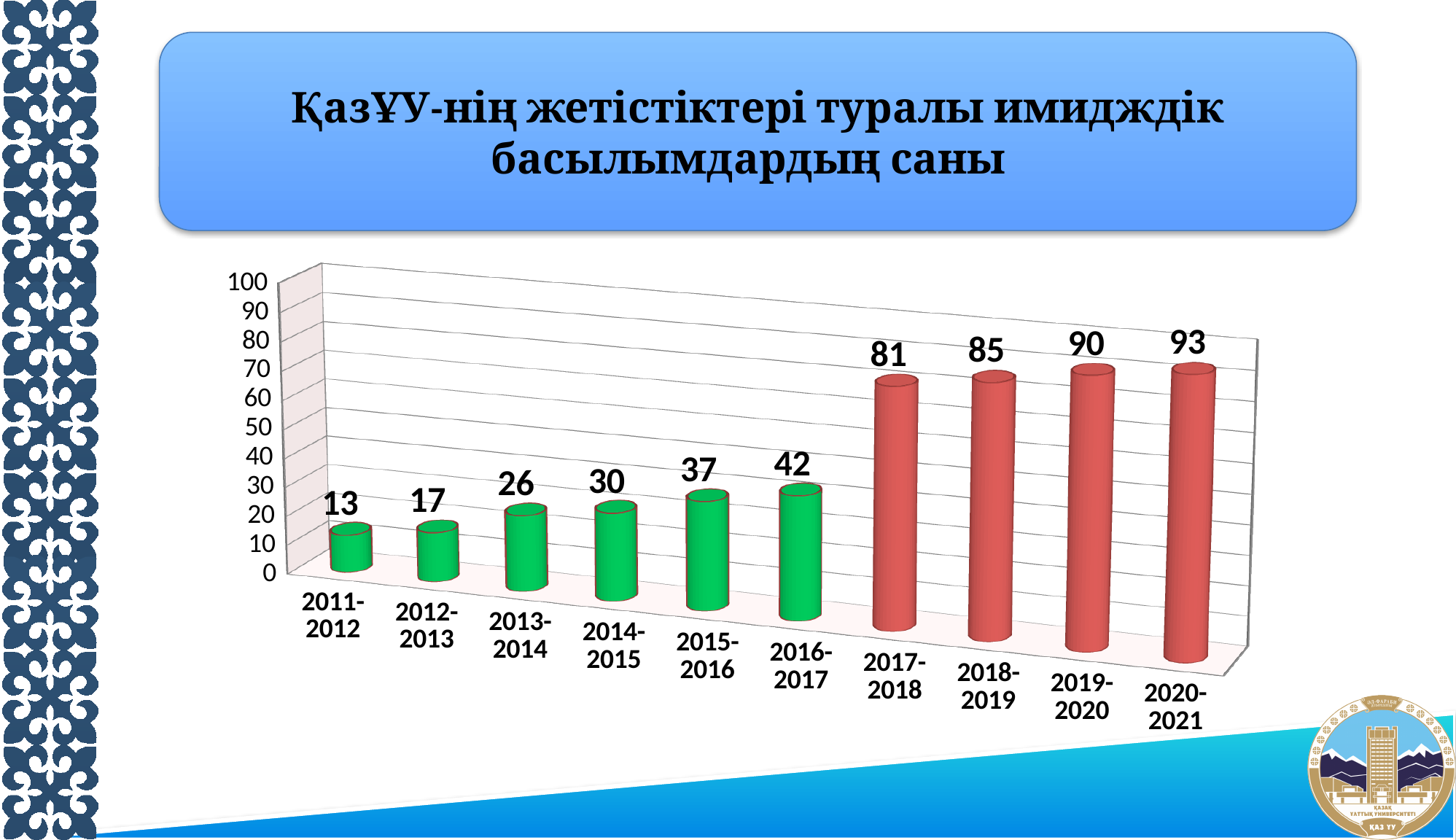
What is the difference between the values for 2020-2021 and 2011-2012? 80 What colour are the bars for 2017-2018 through 2020-2021? red What is the value for 2019-2020? 90 Which period has the highest value? 2020-2021 What is the value for 2011-2012? 13 What kind of chart is shown on the slide? bar chart What is the difference between the values for 2017-2018 and 2016-2017? 39 How many periods are shown on the x axis? 10 Do the values rise or fall from 2011-2012 to 2020-2021? rise Which is larger, the value for 2015-2016 or the value for 2018-2019? 2018-2019 Which period has the lowest value? 2011-2012 What is the value for 2016-2017? 42